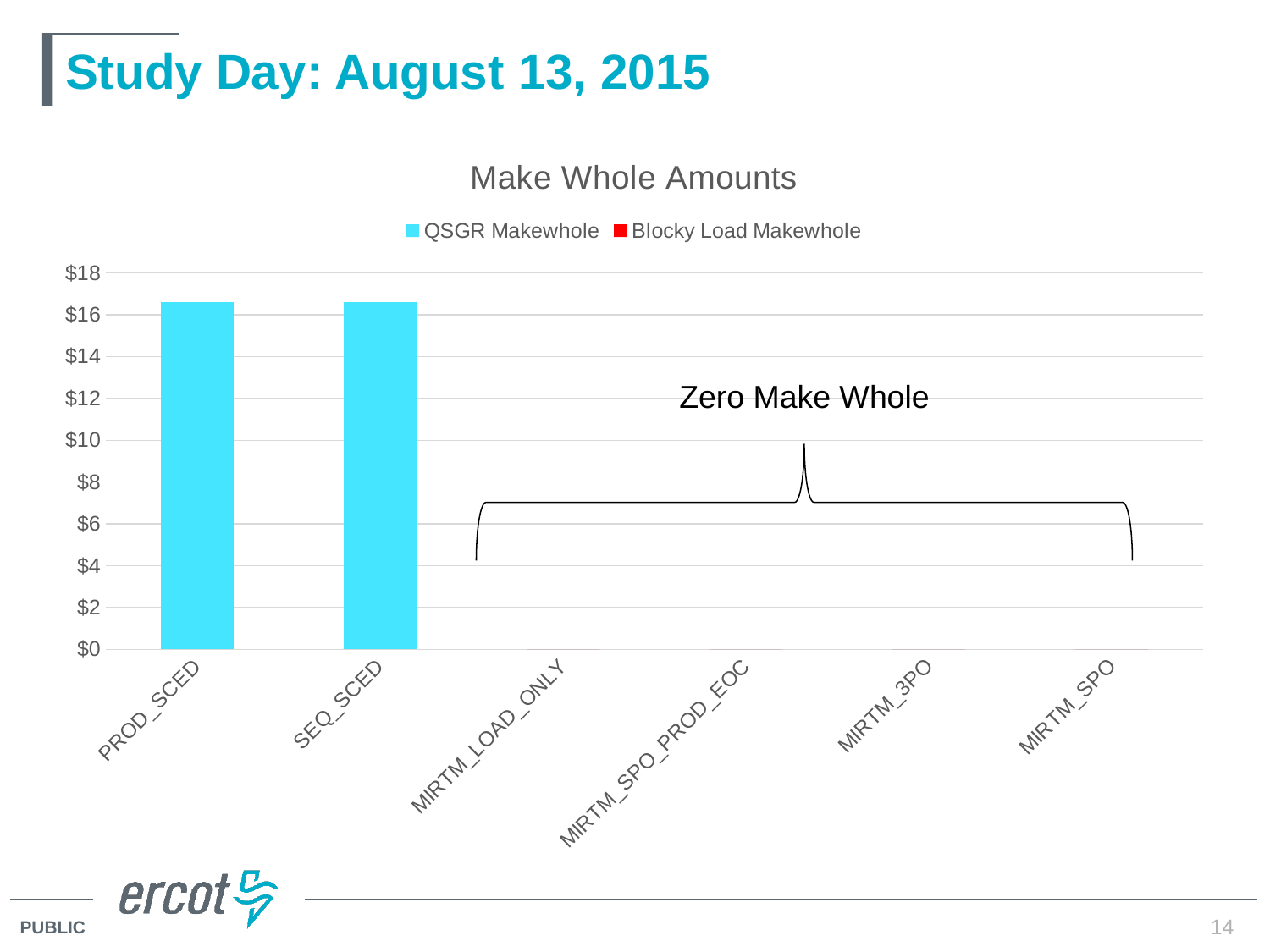
How many categories are shown on the x axis of the chart? 6 How many series does the chart legend list? 2 What is the title of the chart? Make Whole Amounts What kind of chart is shown on the slide? bar chart Is the QSGR Makewhole value for SEQ_SCED greater or less than $10? greater What annotation text is written over the MIRTM categories in the chart? Zero Make Whole Is the QSGR Makewhole value for SEQ_SCED greater or less than $18? less Which category has a larger QSGR Makewhole value, MIRTM_SPO or SEQ_SCED? SEQ_SCED What is the highest value shown on the y axis of the chart? $18 Which category has a larger QSGR Makewhole value, PROD_SCED or MIRTM_3PO? PROD_SCED Is the QSGR Makewhole value for PROD_SCED greater or less than $14? greater